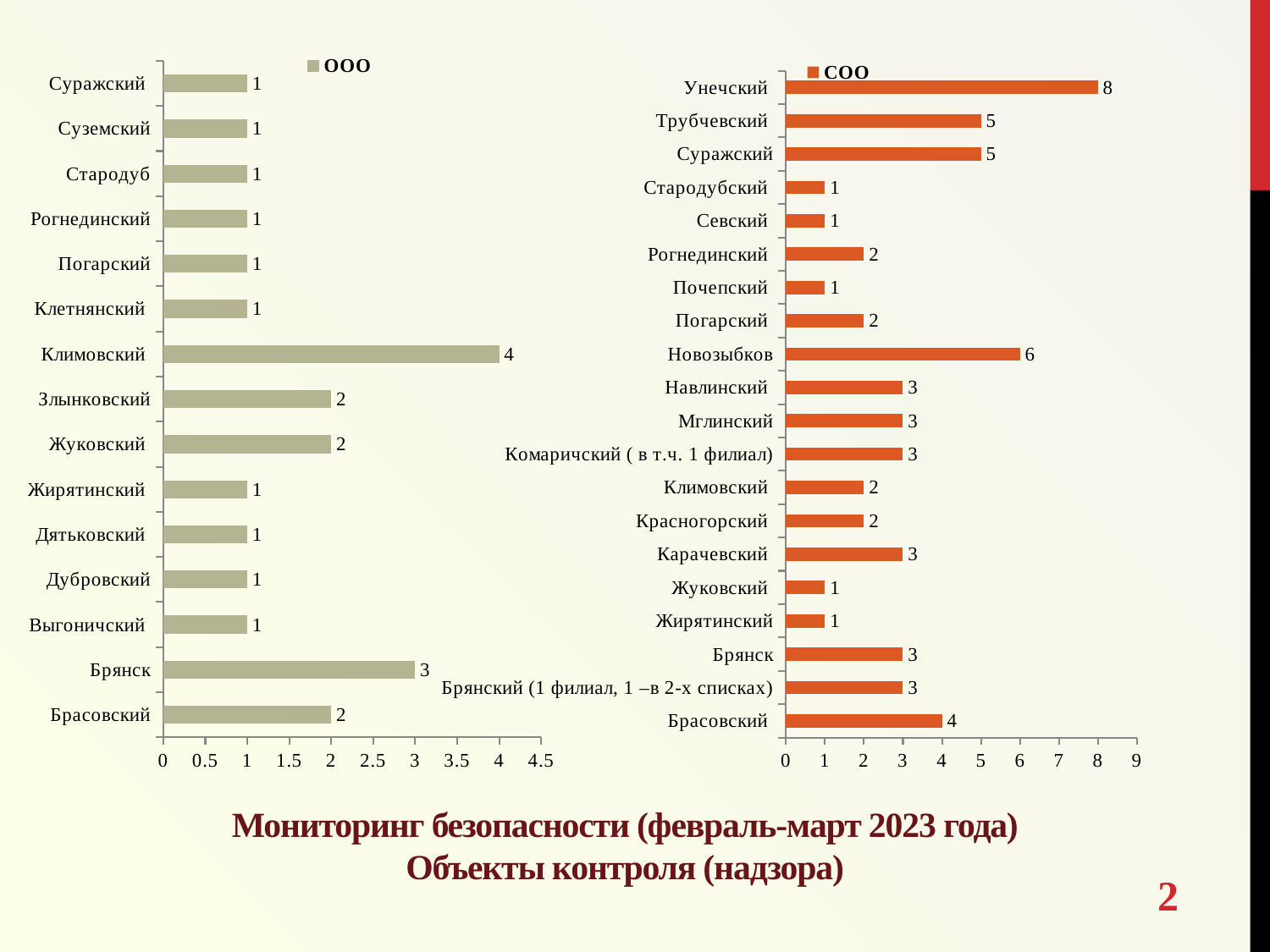
How many categories are shown in the right chart (СОО)? 20 In the left chart (ООО), what is the difference between Брянск and Злынковский? 1 How many categories are shown in the left chart (ООО)? 15 In the right chart (СОО), which category has the highest value? Унечский In the right chart (СОО), what is the value for Новозыбков? 6 In the right chart (СОО), which is larger, Трубчевский or Навлинский? Трубчевский What kind of chart is the right chart (СОО)? Bar chart What series name does the legend of the left chart show? ООО In the left chart (ООО), which category has the highest value? Климовский In the left chart (ООО), what is the value for Климовский? 4 In the right chart (СОО), what is the difference between Унечский and Брасовский? 4 In the left chart (ООО), which is larger, Брянск or Жуковский? Брянск